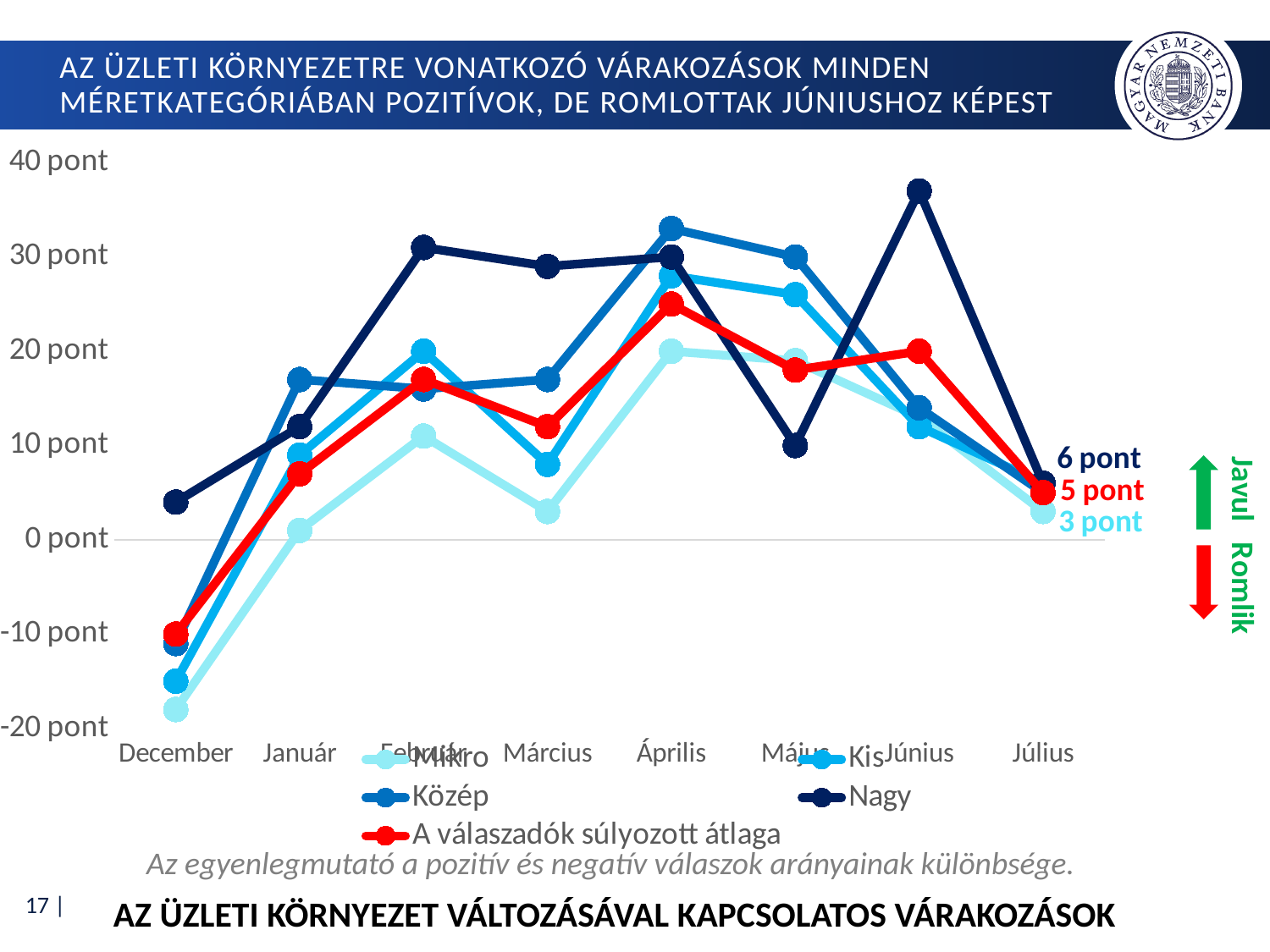
What is the value of the Mikro series in Július? 3 pont What kind of chart is shown on the slide? line chart Is the value for Nagy in Június greater or less than 30 pont? greater How many months are shown along the x axis? 8 Which series has the larger value in Február, Nagy or Mikro? Nagy How many series does the legend list? 5 What is the value of 'A válaszadók súlyozott átlaga' in Július? 5 pont Is the value for Nagy in Május greater or less than 20 pont? less What is the value of the Nagy series in Július? 6 pont What is the difference between the Nagy and Mikro values in Július? 3 pont In which month does the Nagy series reach its highest value? Június In which month does the Mikro series have its lowest value? December